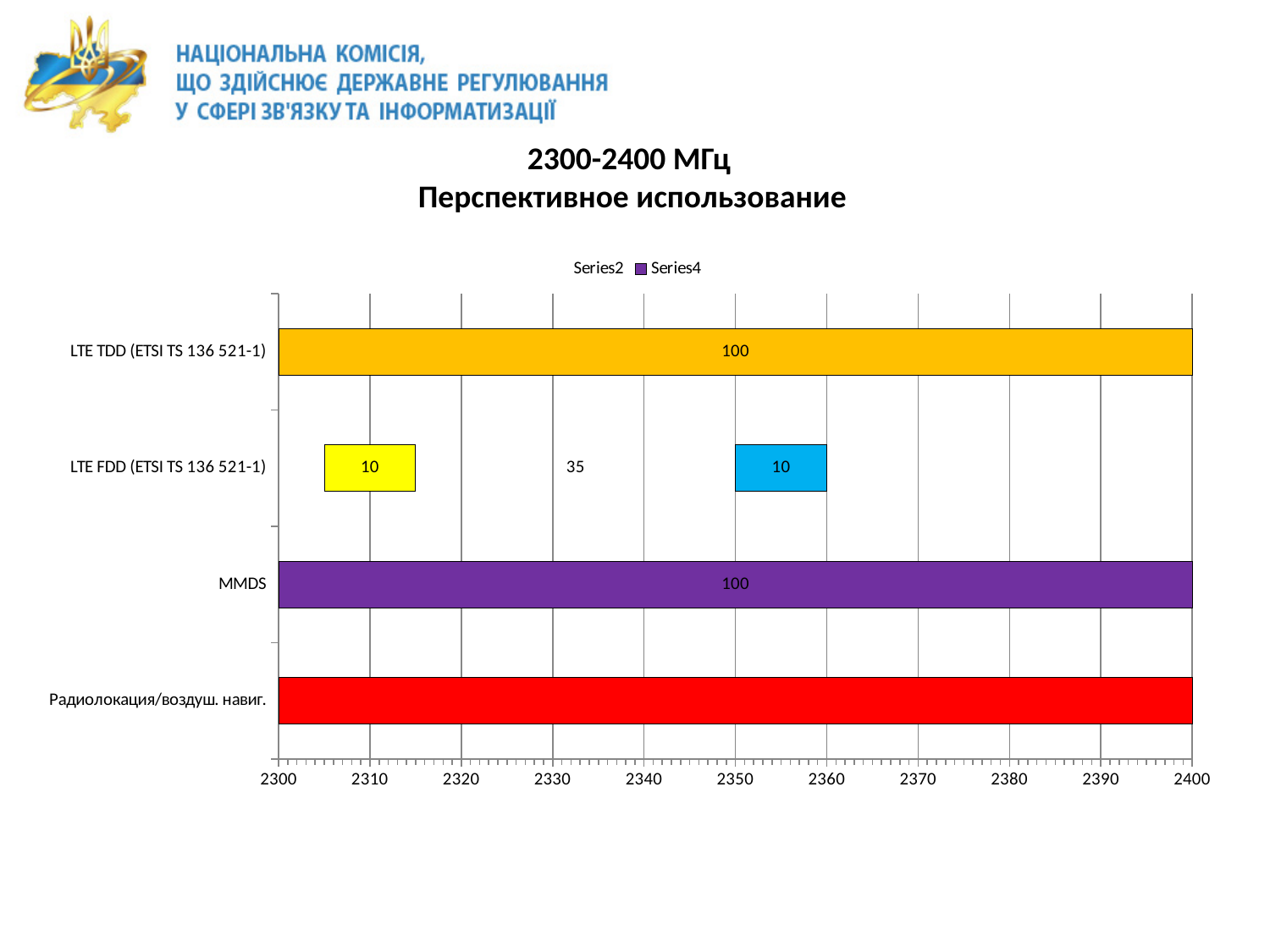
What is the data label on the LTE TDD (ETSI TS 136 521-1) bar? 100 What is the lowest value printed on the horizontal axis of the chart? 2300 What is the data label on the yellow segment of the LTE FDD (ETSI TS 136 521-1) row? 10 How many series does the chart legend list? 2 How many categories are listed on the vertical axis of the chart? 4 What type of chart is shown on the slide? bar chart What value is printed between the yellow and blue segments in the LTE FDD (ETSI TS 136 521-1) row? 35 What is the difference between the LTE TDD (ETSI TS 136 521-1) label value and the yellow LTE FDD segment value? 90 What is the title shown above the chart? 2300-2400 МГц Перспективное использование What is the highest value printed on the horizontal axis of the chart? 2400 What is the data label on the blue segment of the LTE FDD (ETSI TS 136 521-1) row? 10 What is the data label on the MMDS bar? 100